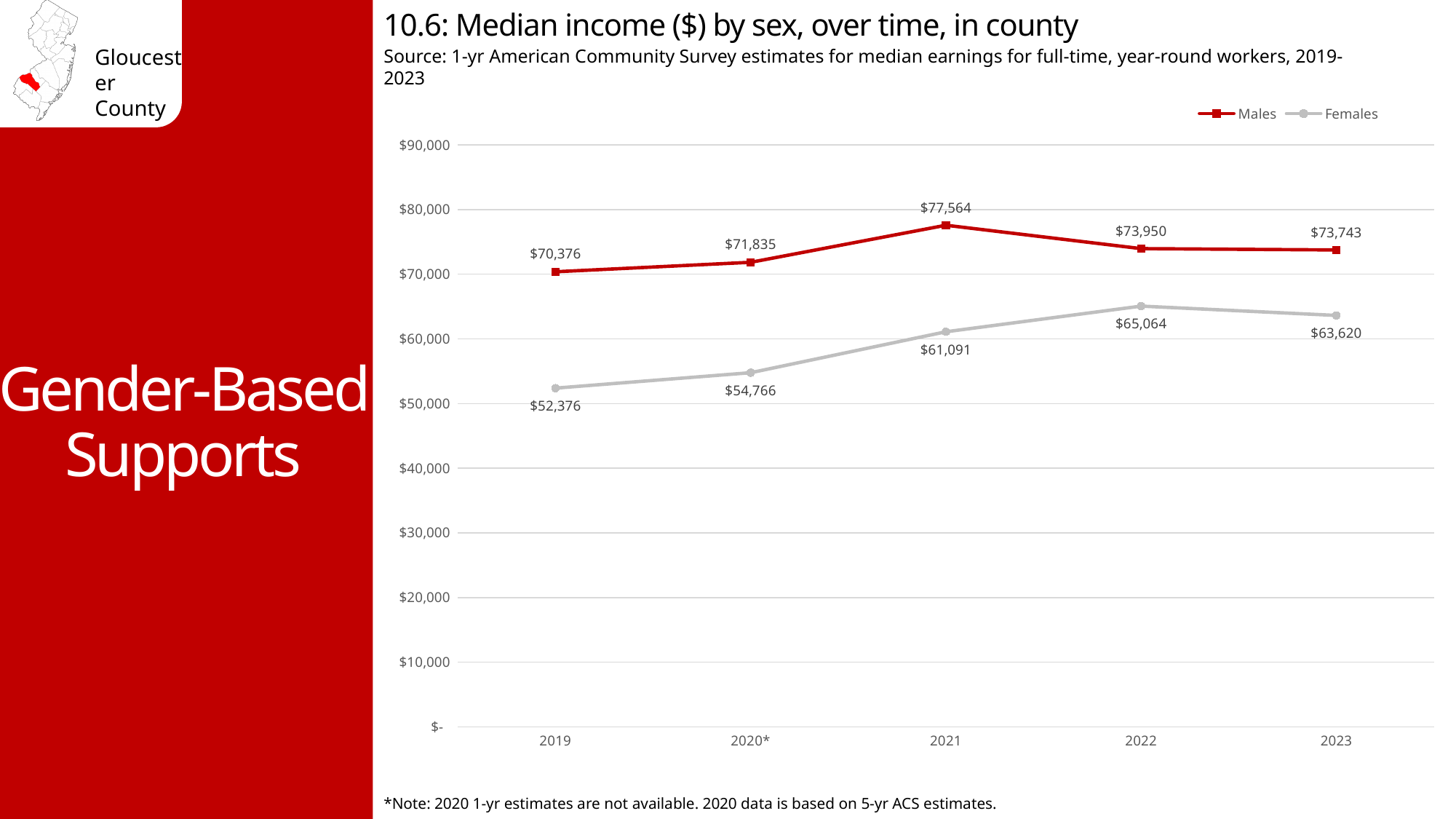
Is the median income for Females in 2021 greater or less than $70,000? less What is the difference between the Males and Females median income in 2022? $8,886 Which was larger in 2020*, the median income for Males or for Females? Males Did the median income for Females rise or fall from 2019 to 2022? rise What was the median income for Females in 2023? $63,620 How many years are shown on the x axis? 5 What was the median income for Males in 2021? $77,564 What was the median income for Females in 2019? $52,376 How many series does the legend list? 2 In which year was the median income for Males highest? 2021 What kind of chart is shown on the slide? line chart In which year was the median income for Females lowest? 2019